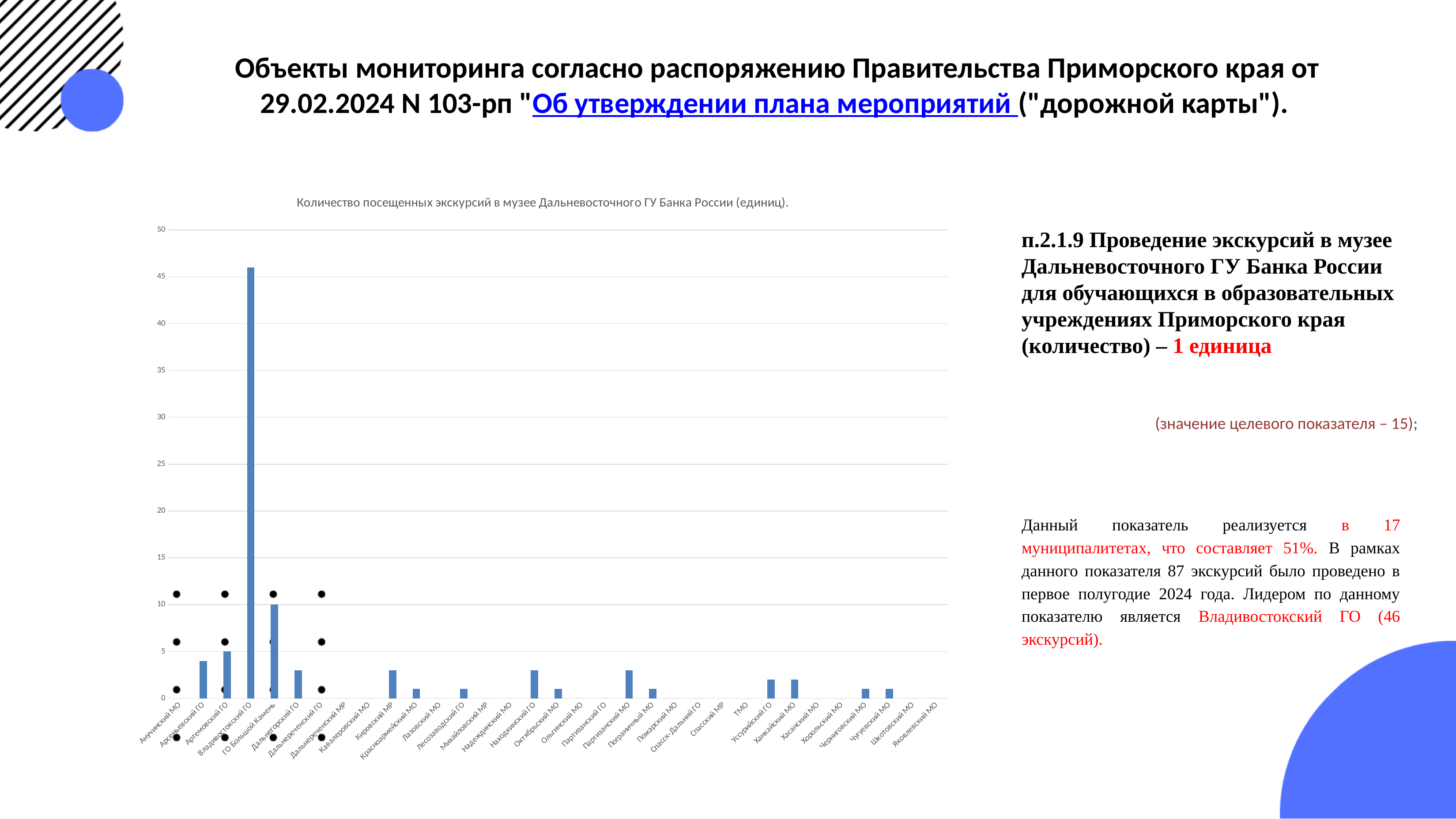
Is the value for Арсеньевский ГО greater or less than 5? less What is the value for Артемовский ГО? 5 What is the title of the chart? Количество посещенных экскурсий в музее Дальневосточного ГУ Банка России (единиц). What is the highest value shown on the vertical axis? 50 What is the difference between the values for Владивостокский ГО and ГО Большой Камень? 36 Which is larger, the value for ГО Большой Камень or the value for Дальнегорский ГО? ГО Большой Камень Is the value for Дальнегорский ГО greater or less than 5? less Which category has the highest value in the chart? Владивостокский ГО What is the value for ГО Большой Камень? 10 Is the value for Владивостокский ГО greater or less than 40? greater What kind of chart is shown on the slide? bar chart What is the value for Владивостокский ГО? 46